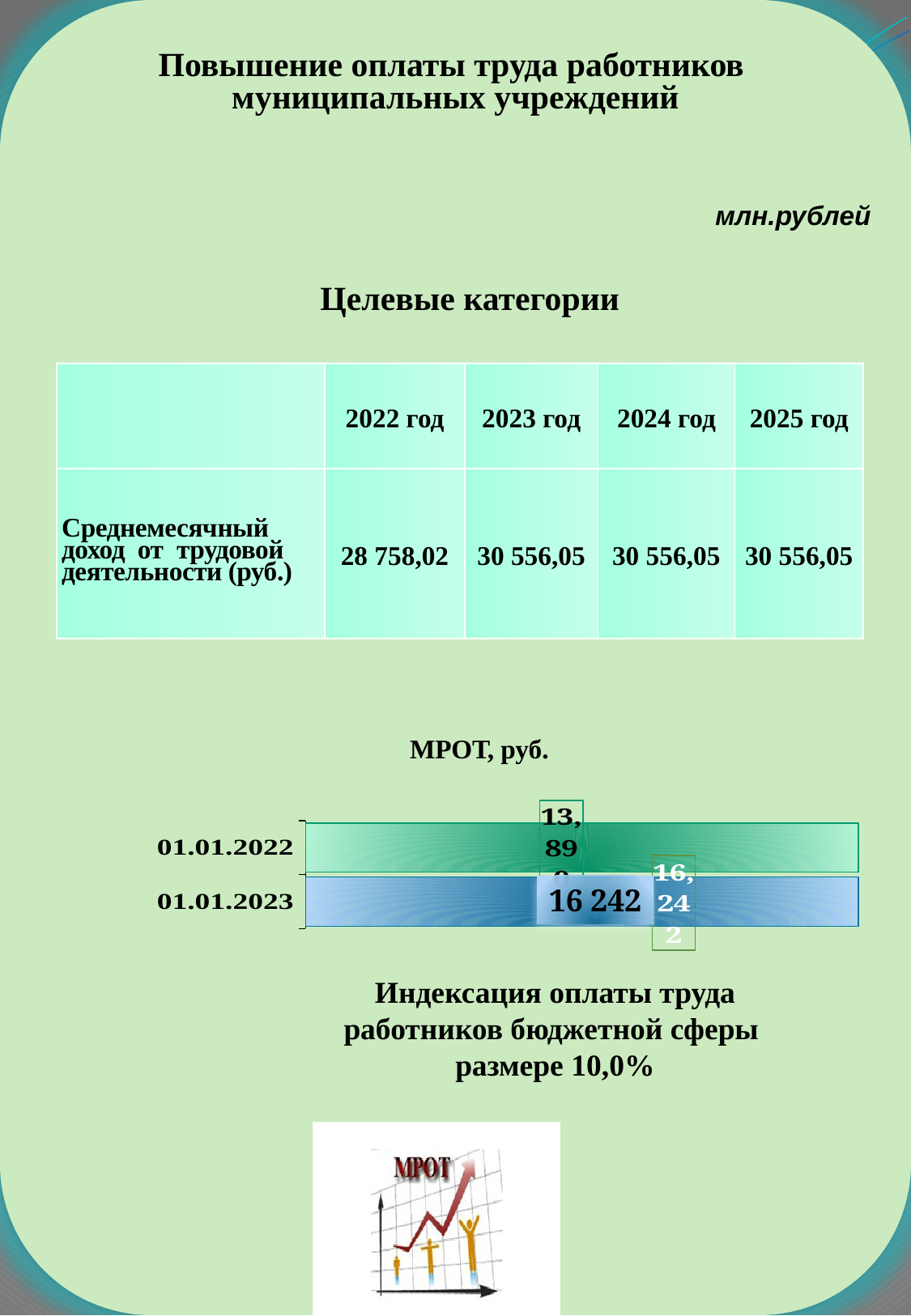
What is the title of the bar chart on the slide? МРОТ, руб. What kind of chart is shown under the title "МРОТ, руб."? bar chart In the "МРОТ, руб." chart, which category is labelled on the lower bar? 01.01.2023 In the "МРОТ, руб." chart, what is the value for 01.01.2023? 16 242 How many categories (dates) are plotted in the "МРОТ, руб." chart? 2 In the "МРОТ, руб." chart, does the value increase or decrease from 01.01.2022 to 01.01.2023? increase In the "МРОТ, руб." chart, which is larger: the value for 01.01.2022 or for 01.01.2023? 01.01.2023